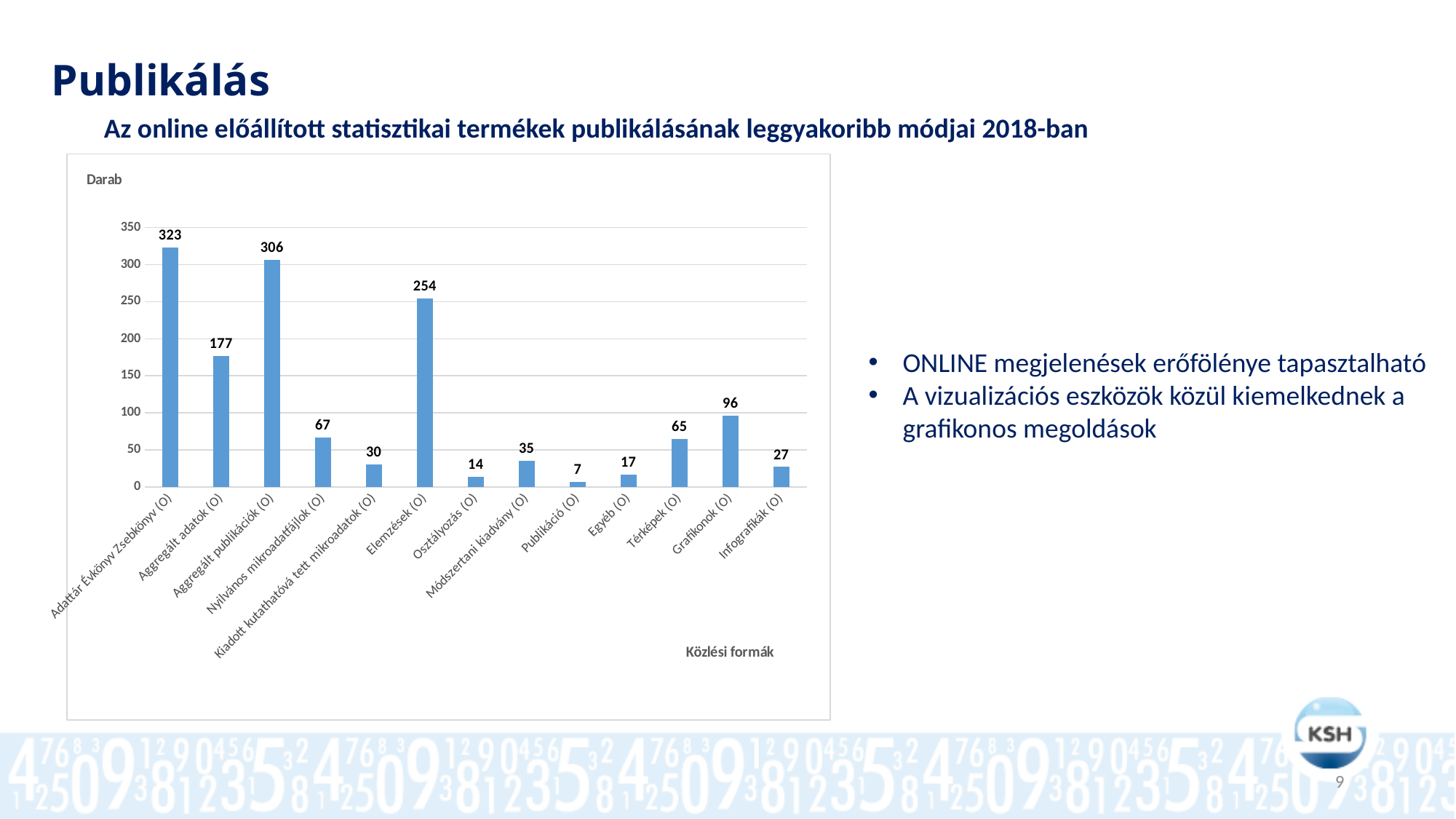
What is the difference between the values for Adattár Évkönyv Zsebkönyv (O) and Aggregált publikációk (O)? 17 What is the value for Adattár Évkönyv Zsebkönyv (O)? 323 What is the difference between the values for Grafikonok (O) and Térképek (O)? 31 What kind of chart is shown on the slide? bar chart Which category has the highest value? Adattár Évkönyv Zsebkönyv (O) What is the value for Elemzések (O)? 254 How many categories are shown on the x axis? 13 Is the value for Nyilvános mikroadatfájlok (O) greater or less than 100? less Which category has the lowest value? Publikáció (O) What is the value for Grafikonok (O)? 96 Which is larger, the value for Aggregált adatok (O) or the value for Elemzések (O)? Elemzések (O) What is the label of the vertical axis? Darab